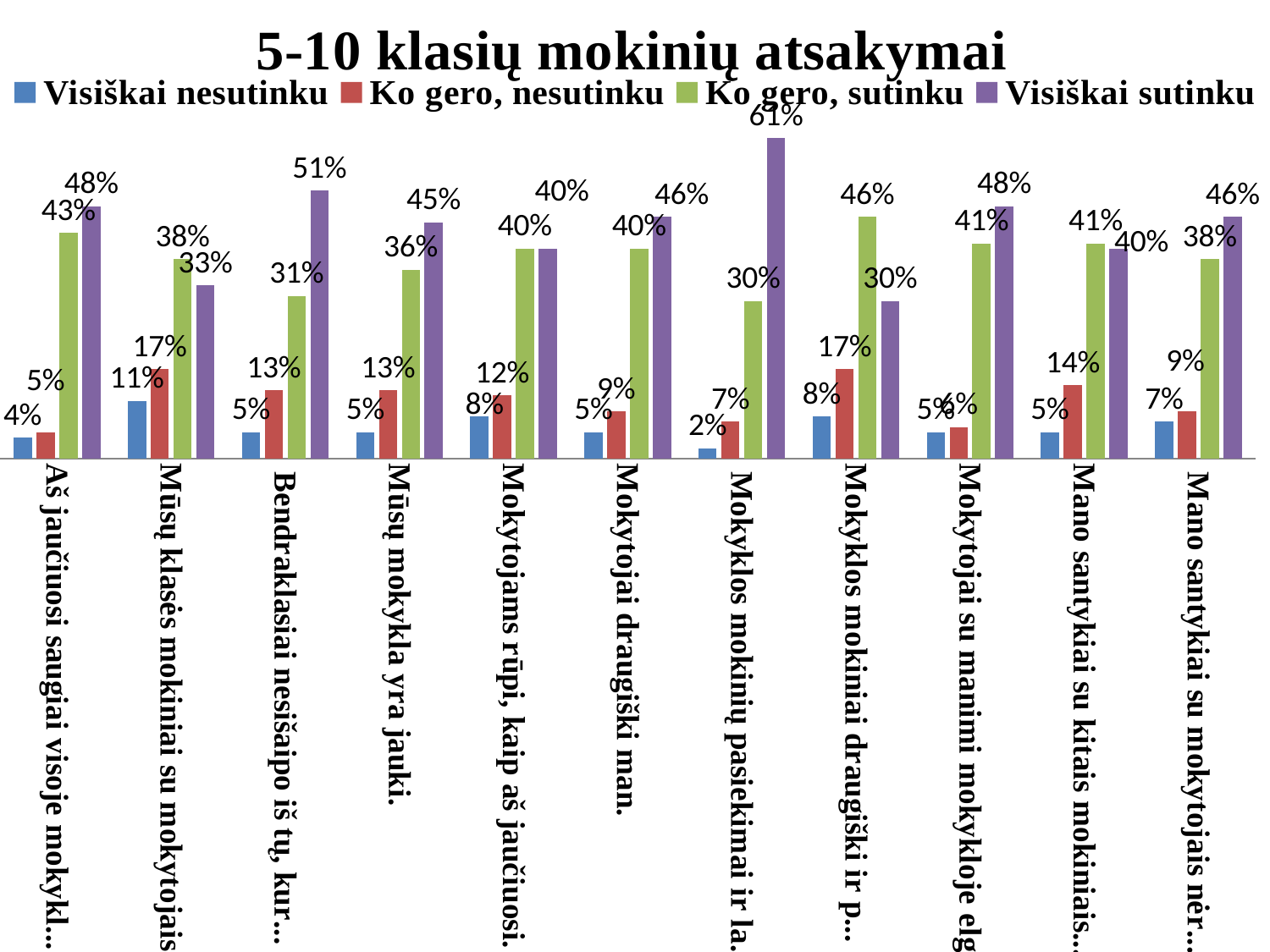
For 'Mokytojai draugiški man.', which is larger: 'Ko gero, sutinku' or 'Visiškai sutinku'? Visiškai sutinku How many categories are shown on the x axis? 11 How many series does the legend list? 4 What is the value of 'Visiškai sutinku' for 'Mūsų mokykla yra jauki.'? 45% Which colour represents the 'Ko gero, sutinku' series? green Which category has the highest 'Visiškai sutinku' value? Mokyklos mokinių pasiekimai ir la... What is the difference between 'Visiškai sutinku' and 'Ko gero, sutinku' for 'Mūsų mokykla yra jauki.'? 9% What is the title of the chart? 5-10 klasių mokinių atsakymai What is the value of 'Ko gero, nesutinku' for 'Mokytojai draugiški man.'? 9% What kind of chart is shown on the slide? bar chart What is the value of 'Ko gero, sutinku' for 'Mokytojams rūpi, kaip aš jaučiuosi.'? 40% What is the value of 'Visiškai nesutinku' for 'Mokytojams rūpi, kaip aš jaučiuosi.'? 8%